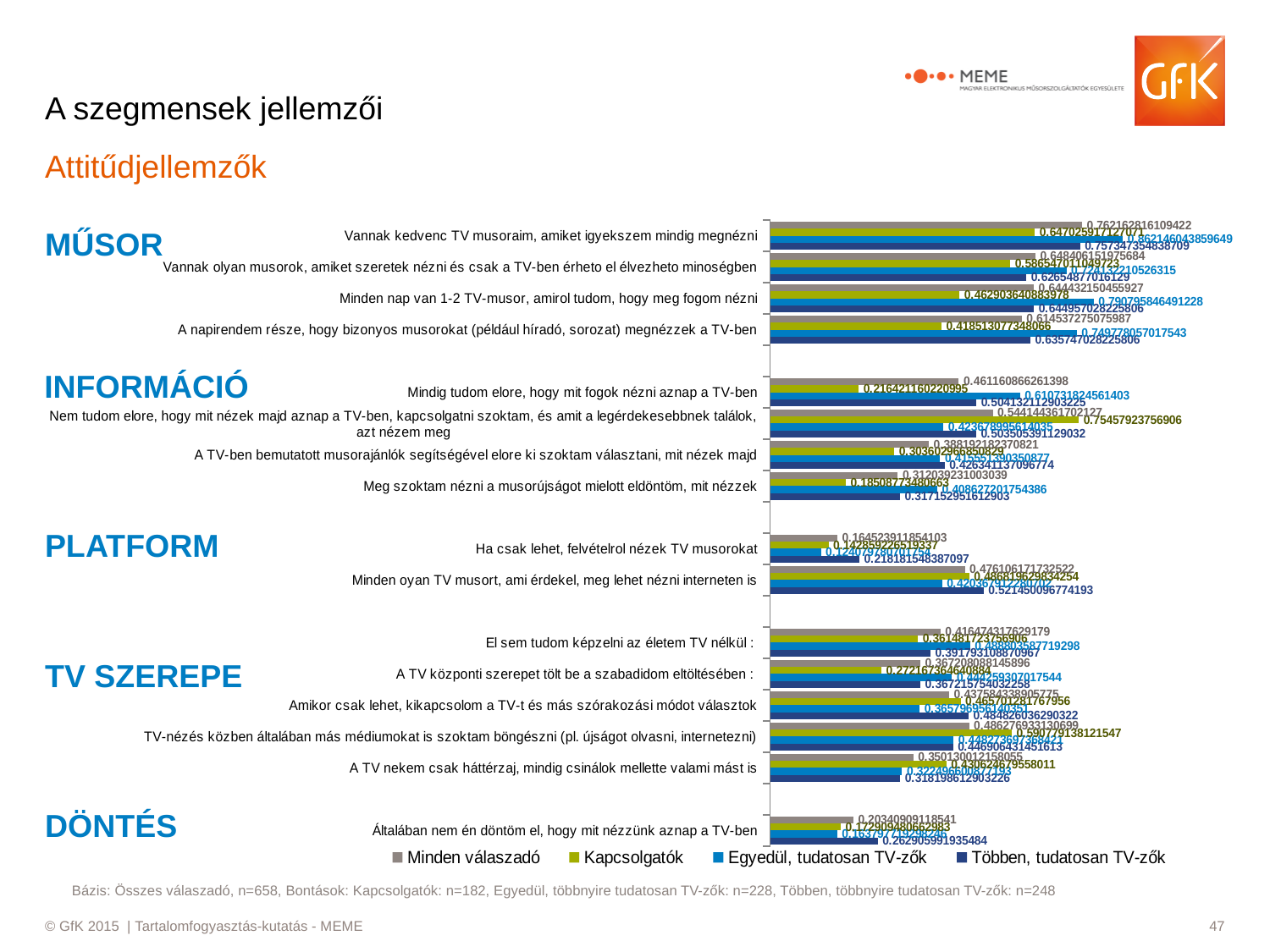
What is the value for Minden válaszadó on 'Vannak kedvenc TV musoraim, amiket igyekszem mindig megnézni'? 0.762162816109422 For which statement is the Minden válaszadó value lowest? Ha csak lehet, felvételrol nézek TV musorokat What is the difference between the Minden válaszadó and Kapcsolgatók values on 'Vannak kedvenc TV musoraim, amiket igyekszem mindig megnézni'? 0.115136898982351 For which statement is the Minden válaszadó value highest? Vannak kedvenc TV musoraim, amiket igyekszem mindig megnézni What is the value for Többen, tudatosan TV-zők on 'Általában nem én döntöm el, hogy mit nézzünk aznap a TV-ben'? 0.262905991935484 What is the value for Minden válaszadó on 'Ha csak lehet, felvételrol nézek TV musorokat'? 0.164523911854103 Which is larger for Minden válaszadó: 'Vannak kedvenc TV musoraim, amiket igyekszem mindig megnézni' or 'Általában nem én döntöm el, hogy mit nézzünk aznap a TV-ben'? Vannak kedvenc TV musoraim, amiket igyekszem mindig megnézni How many series does the legend list? 4 Which series are listed in the legend? Minden válaszadó, Kapcsolgatók, Egyedül, tudatosan TV-zők, Többen, tudatosan TV-zők What is the value for Kapcsolgatók on 'Mindig tudom elore, hogy mit fogok nézni aznap a TV-ben'? 0.216421160220995 What kind of chart is shown on the slide? bar chart How many statements (categories) are plotted on the chart? 16